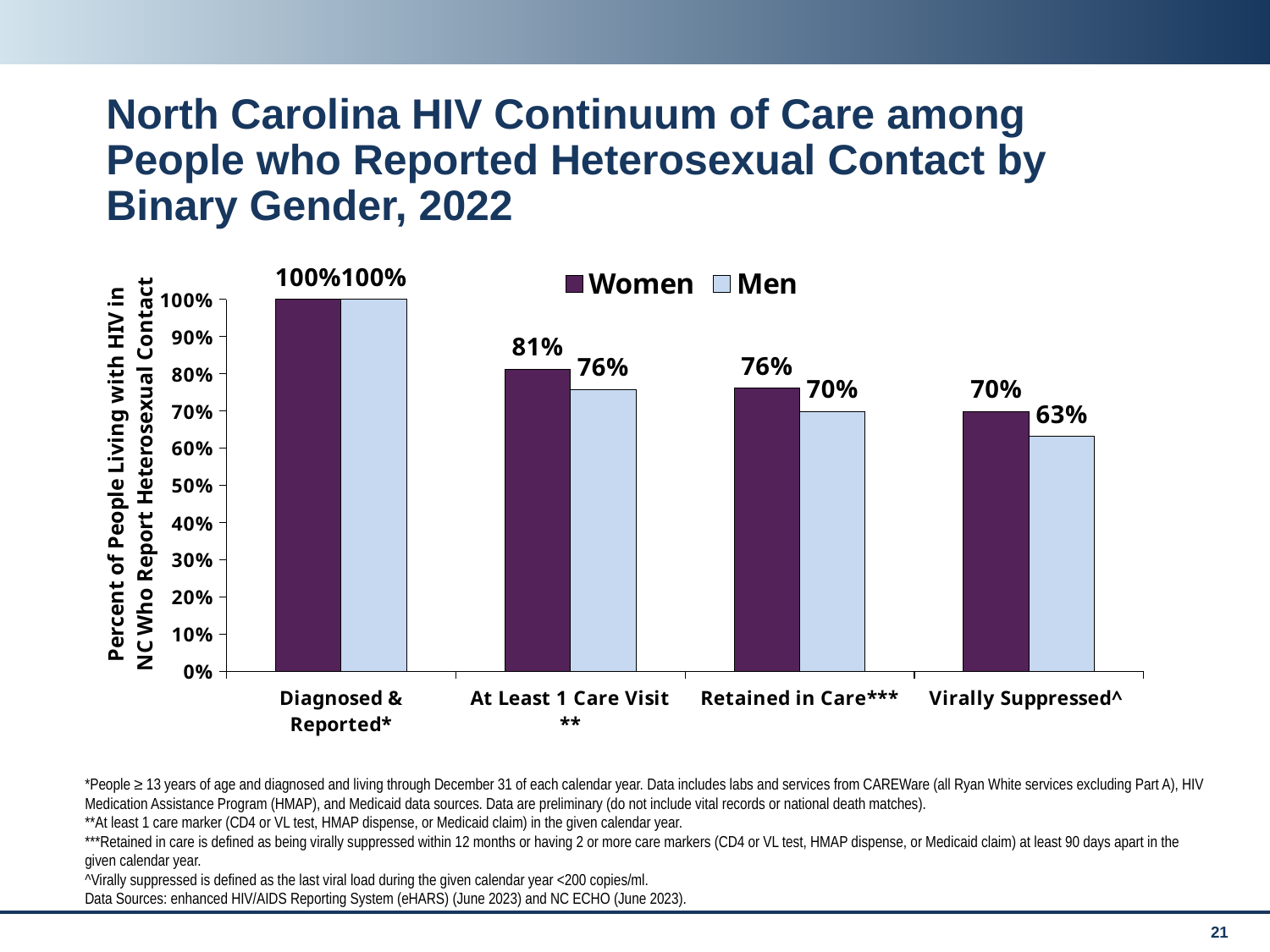
Which category has the lowest value for Men? Virally Suppressed^ What is the value for Men in the At Least 1 Care Visit ** category? 76% What is the value for Women in the Retained in Care*** category? 76% How many categories are shown on the x axis? 4 How many series does the legend list? 2 In the Retained in Care*** category, which series has the larger value, Women or Men? Women Which category has the highest value for Women? Diagnosed & Reported* What is the difference between the Women and Men values in the Virally Suppressed^ category? 7% What is the difference between the Women and Men values in the At Least 1 Care Visit ** category? 5% What is the value for Men in the Virally Suppressed^ category? 63% What kind of chart is shown on the slide? Bar chart Do the values for Women rise or fall from left to right across the categories? Fall